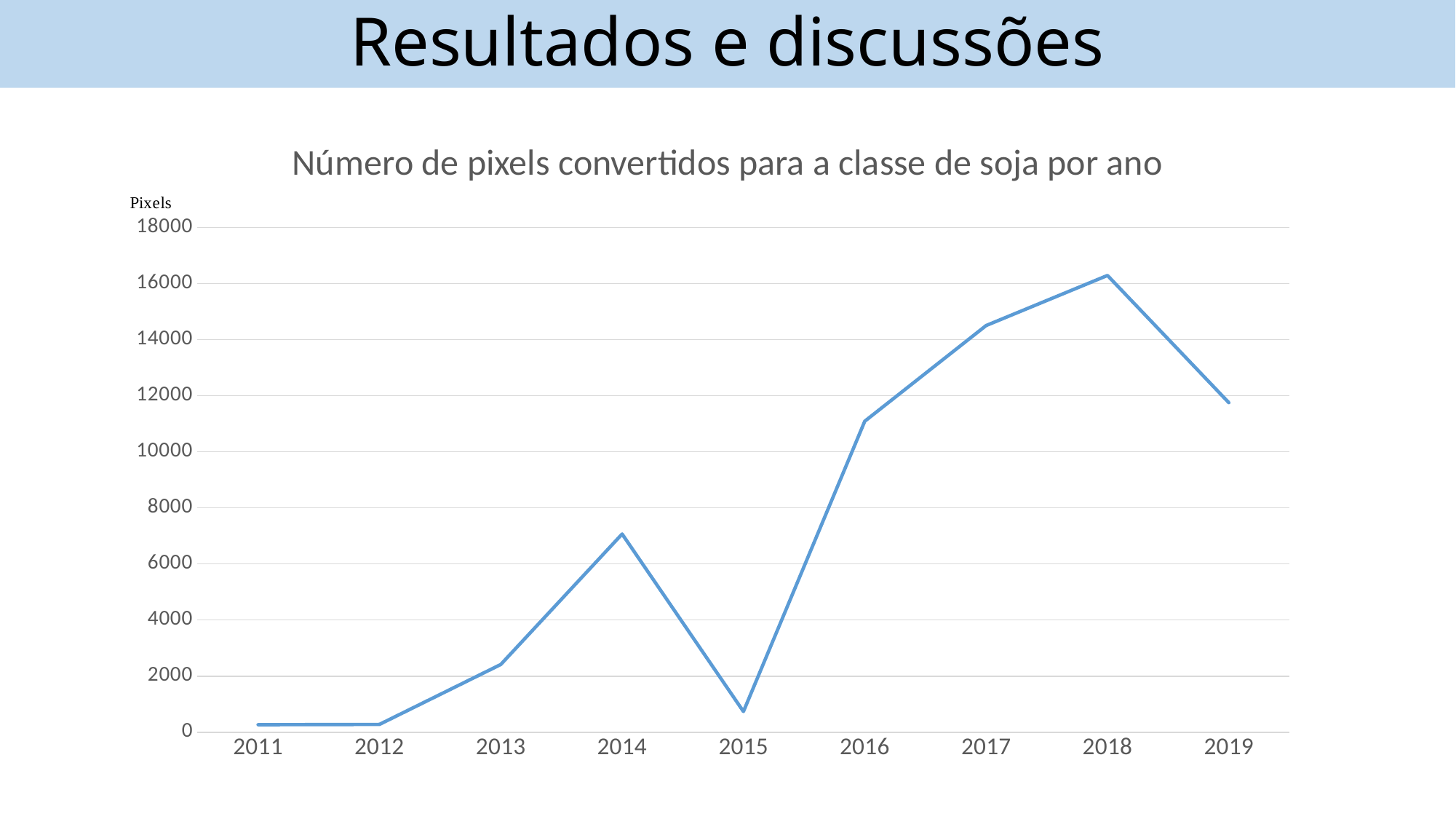
Is the value for 2016 greater or less than 10000? greater Is the value for 2014 greater or less than 6000? greater Is the value for 2018 greater or less than 16000? greater Does the line rise or fall from 2018 to 2019? fall Which is larger, the value for 2017 or the value for 2019? 2017 How many years are plotted on the x axis? 9 Which is larger, the value for 2014 or the value for 2013? 2014 What kind of chart is shown on the slide? line chart What is the title of the chart? Número de pixels convertidos para a classe de soja por ano Which year has the highest number of pixels converted? 2018